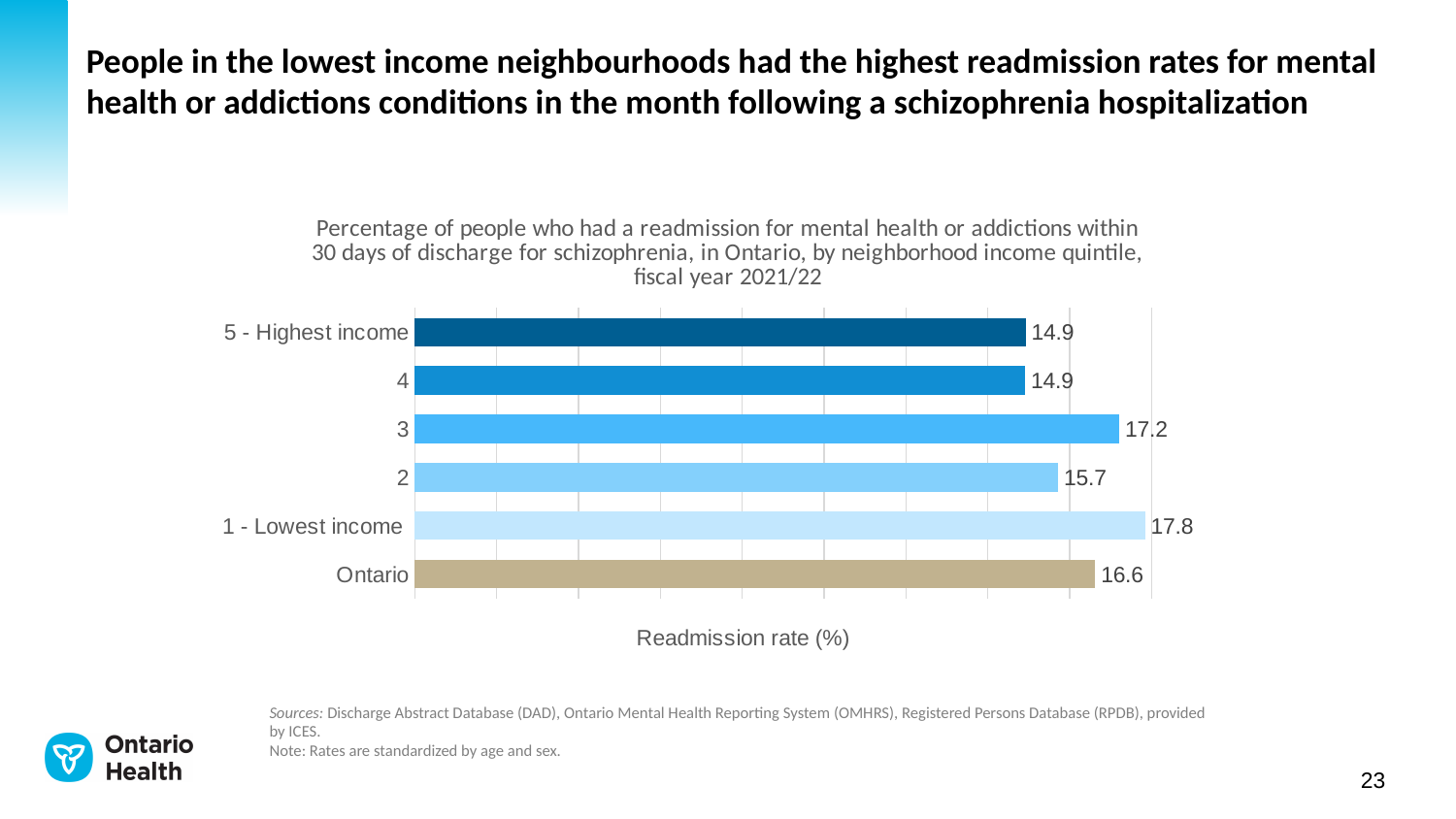
What is the readmission rate for the 5 - Highest income quintile? 14.9 What is the difference in readmission rate between quintile 3 and quintile 2? 1.5 What is the difference in readmission rate between the 1 - Lowest income quintile and the 5 - Highest income quintile? 2.9 Which has a higher readmission rate, Ontario or quintile 4? Ontario What is the readmission rate for quintile 3? 17.2 What is the readmission rate for the 1 - Lowest income quintile? 17.8 What is the label of the x axis? Readmission rate (%) Which category has the highest readmission rate? 1 - Lowest income Which has a higher readmission rate, quintile 2 or quintile 3? 3 What is the readmission rate for Ontario overall? 16.6 How many bars are shown in the chart? 6 What type of chart is shown on the slide? Bar chart